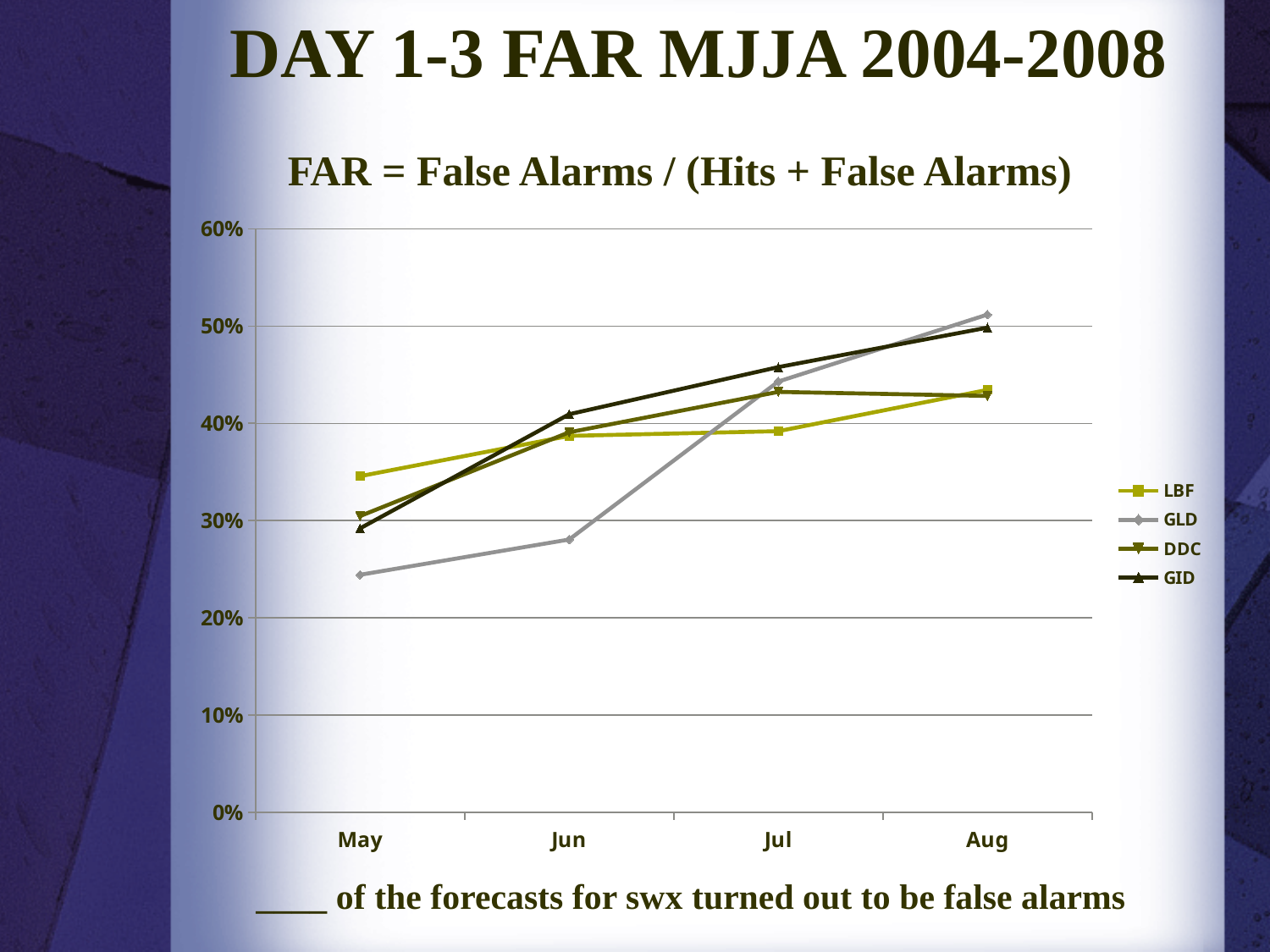
Is the value for GLD in Jul greater or less than 40%? greater What is the title of the slide containing the chart? DAY 1-3 FAR MJJA 2004-2008 In May, which is larger, the value for LBF or the value for GLD? LBF How many months are shown along the x axis? 4 Is the value for GID in Aug greater or less than 40%? greater Is the value for LBF in May greater or less than 30%? greater What kind of chart is shown on the slide? line chart How many series does the legend list? 4 Does the GLD line rise or fall from May to Aug? rise Which series has the lowest value in Jun? GLD In Jun, which is larger, the value for GLD or the value for GID? GID